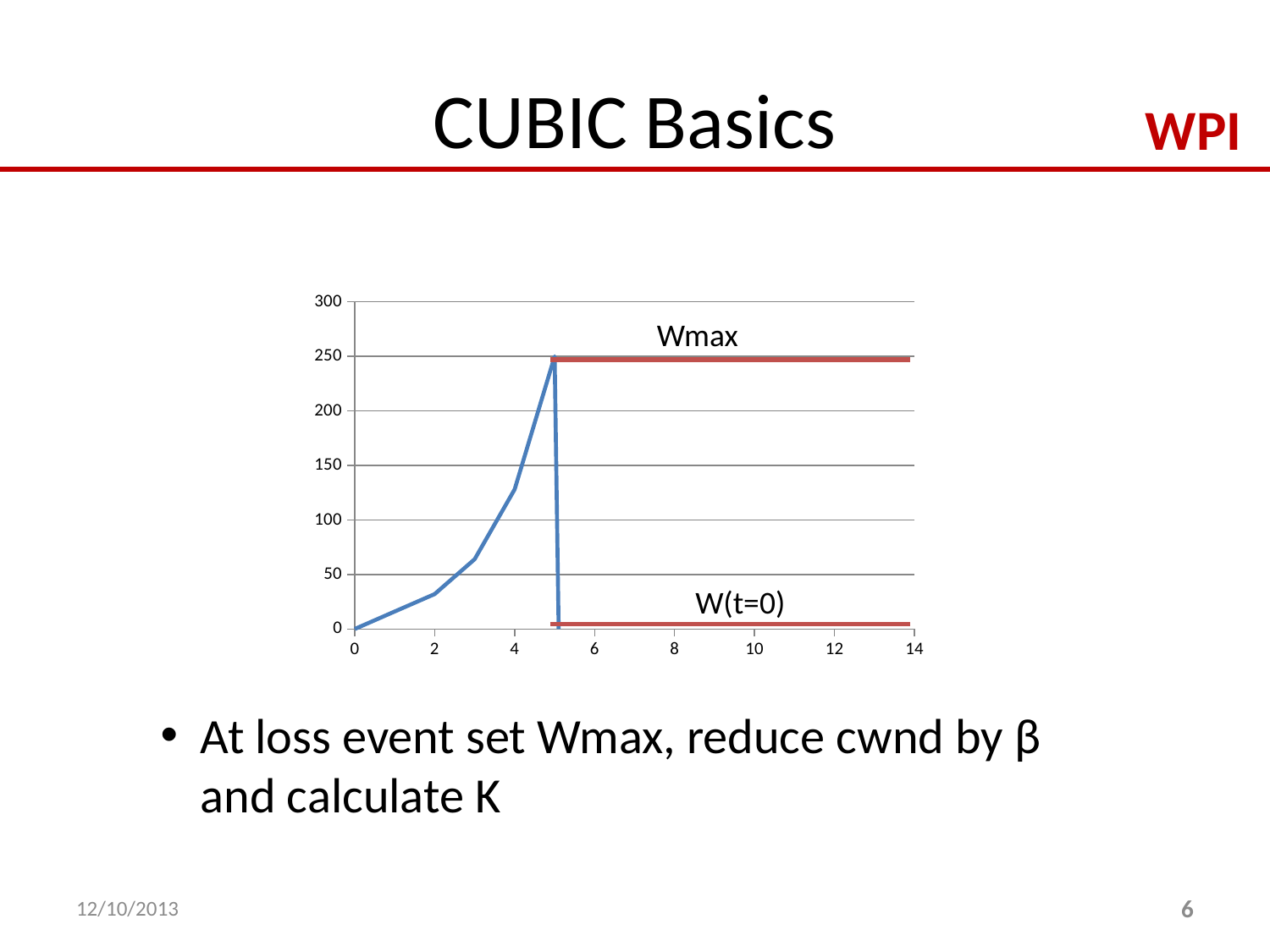
Is the value of the blue line at x = 2 greater or less than 50? less What kind of chart is shown on the slide? line chart What is the highest value shown on the y axis? 300 Does the blue line rise or fall between x = 0 and x = 5? rise Is the horizontal line labelled W(t=0) greater or less than 50? less What are the labels of the two horizontal red lines on the chart? Wmax and W(t=0) Near which x-axis tick does the blue line reach its peak? 5 Is the value of the blue line at x = 4 greater or less than 100? greater Which horizontal red line is higher, Wmax or W(t=0)? Wmax